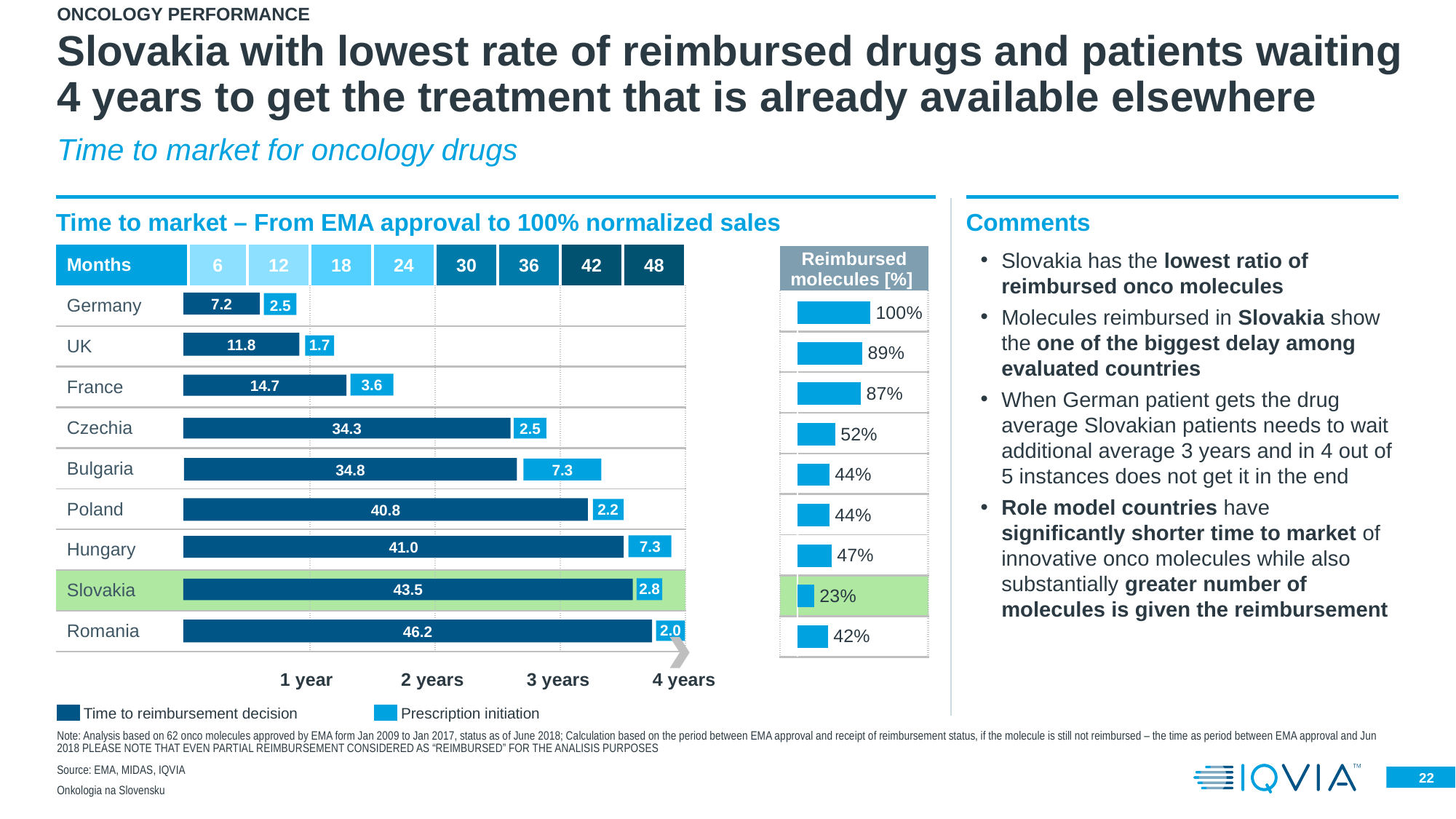
How many series does the legend of the 'Time to market' chart list? 2 In the 'Time to market' chart, what is the prescription initiation value for Bulgaria? 7.3 In the 'Reimbursed molecules [%]' chart, which country has the highest share of reimbursed molecules? Germany In the 'Time to market' chart, which is larger: the time to reimbursement decision for Poland or for Czechia? Poland In the 'Time to market' chart, which country has the longest time to reimbursement decision? Romania In the 'Time to market' chart, which country has the shortest time to reimbursement decision? Germany How many countries are shown in the 'Time to market' chart? 9 What kind of chart is the 'Time to market – From EMA approval to 100% normalized sales' chart? Stacked bar chart In the 'Time to market' chart, what is the time to reimbursement decision for Slovakia? 43.5 In the 'Time to market' chart, what is the total of the stacked bar for Hungary? 48.3 In the 'Reimbursed molecules [%]' chart, what is the value for Slovakia? 23% In the 'Time to market' chart, what is the difference in time to reimbursement decision between Slovakia and Germany? 36.3